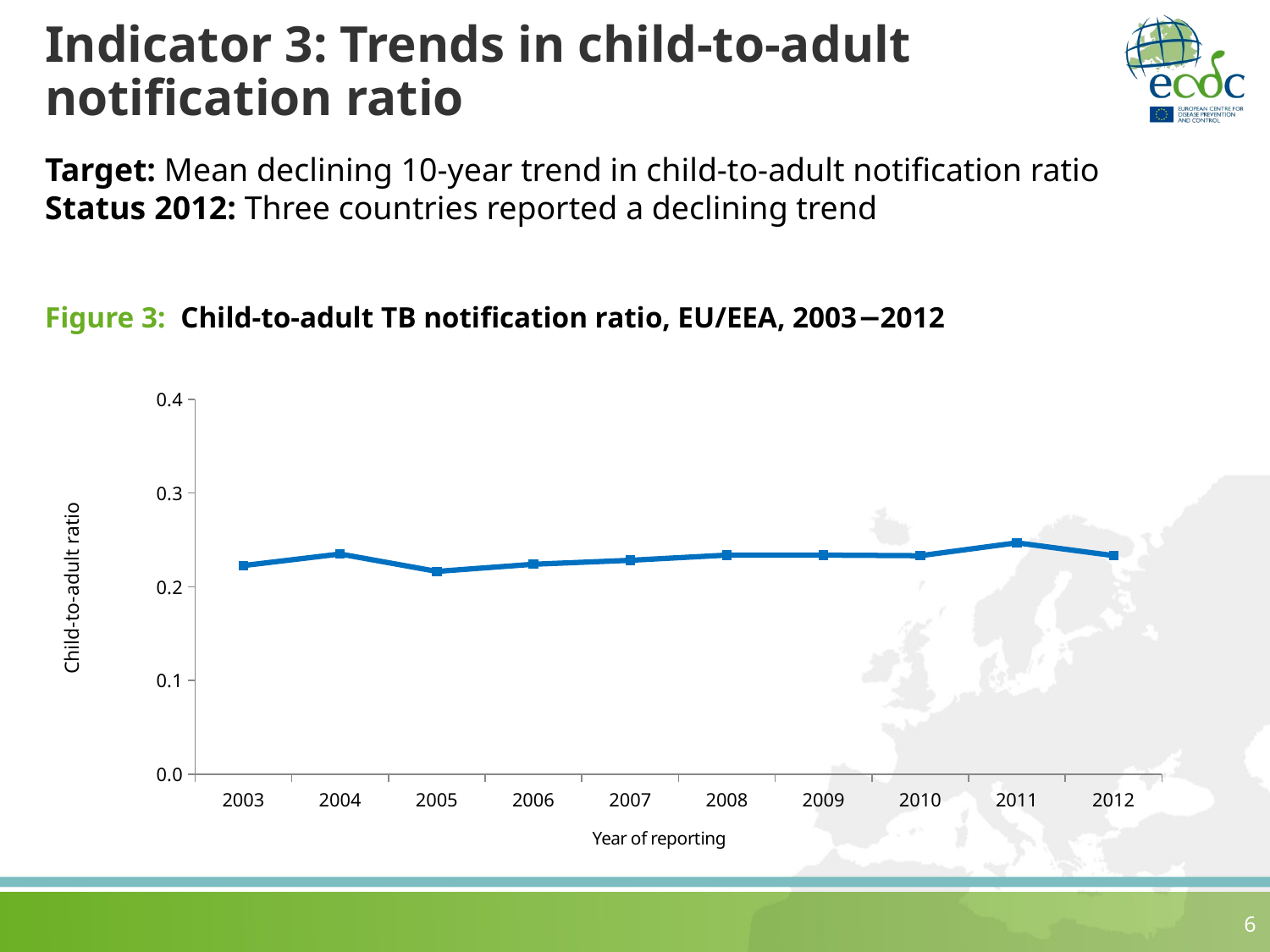
Which year has the lowest child-to-adult ratio in the chart? 2005 What is the title of the figure on the slide? Child-to-adult TB notification ratio, EU/EEA, 2003−2012 Is the child-to-adult ratio for 2003 greater or less than 0.3? less What is the label of the x axis of the chart? Year of reporting How many years are plotted on the x axis of the chart? 10 Is the child-to-adult ratio for 2011 greater or less than 0.3? less What kind of chart is shown on the slide? Line chart Which year has the highest child-to-adult ratio in the chart? 2011 Which year has the larger child-to-adult ratio, 2004 or 2005? 2004 Is the child-to-adult ratio for 2005 greater or less than 0.2? greater Which year has the larger child-to-adult ratio, 2005 or 2011? 2011